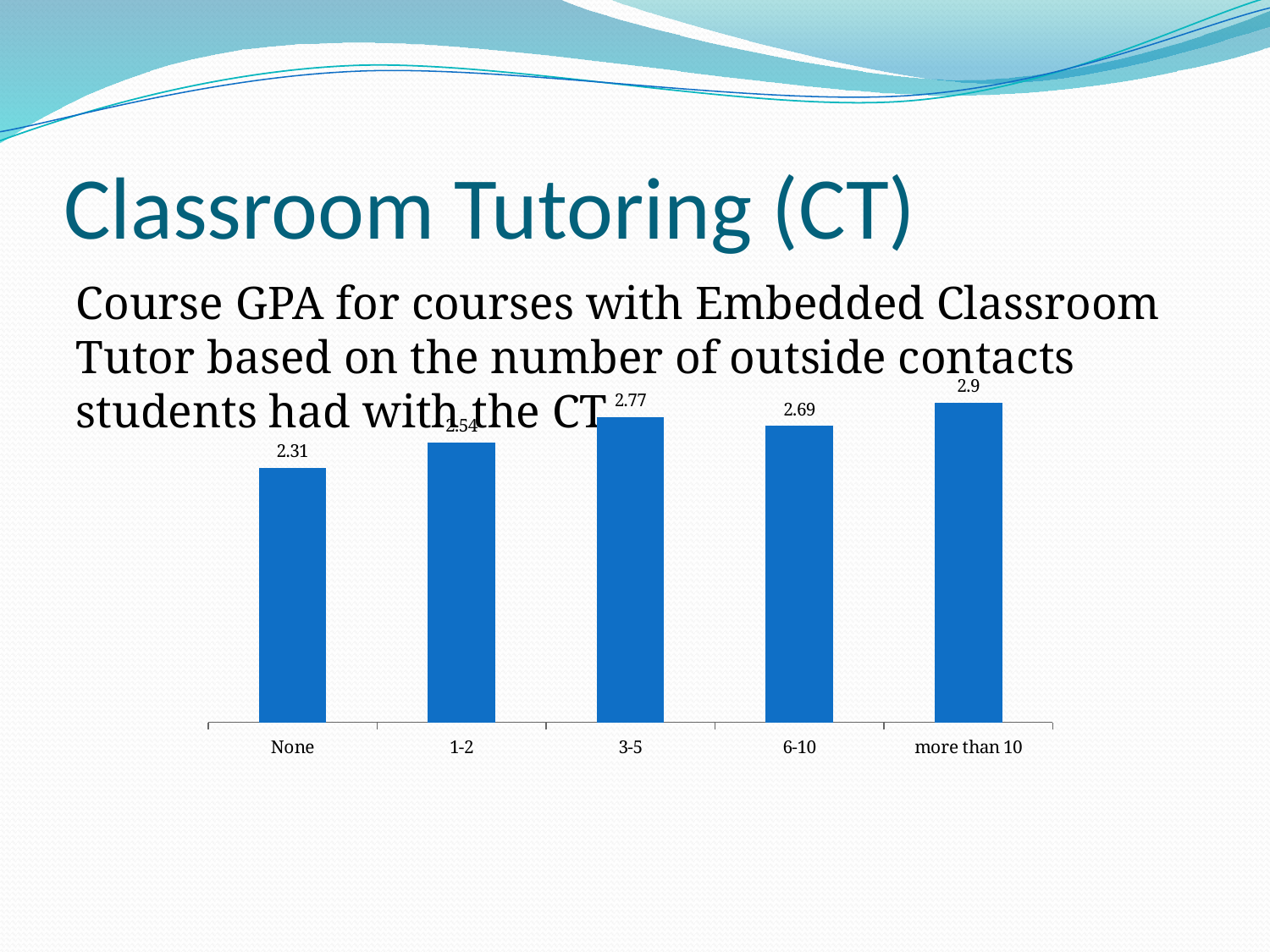
Which has a higher course GPA, the 3-5 category or the 6-10 category? 3-5 How many categories are shown on the x axis? 5 What kind of chart is shown on the slide? Bar chart What is the course GPA for the 'more than 10' contacts category? 2.9 What colour are the bars in the chart? Blue What is the difference in course GPA between the 'more than 10' category and the 'None' category? 0.59 Which category has the highest course GPA? more than 10 Which category has the lowest course GPA? None What is the difference in course GPA between the 3-5 category and the 6-10 category? 0.08 What is the course GPA for the 3-5 contacts category? 2.77 What is the course GPA for the 6-10 contacts category? 2.69 What is the course GPA for students with no outside contacts (None)? 2.31